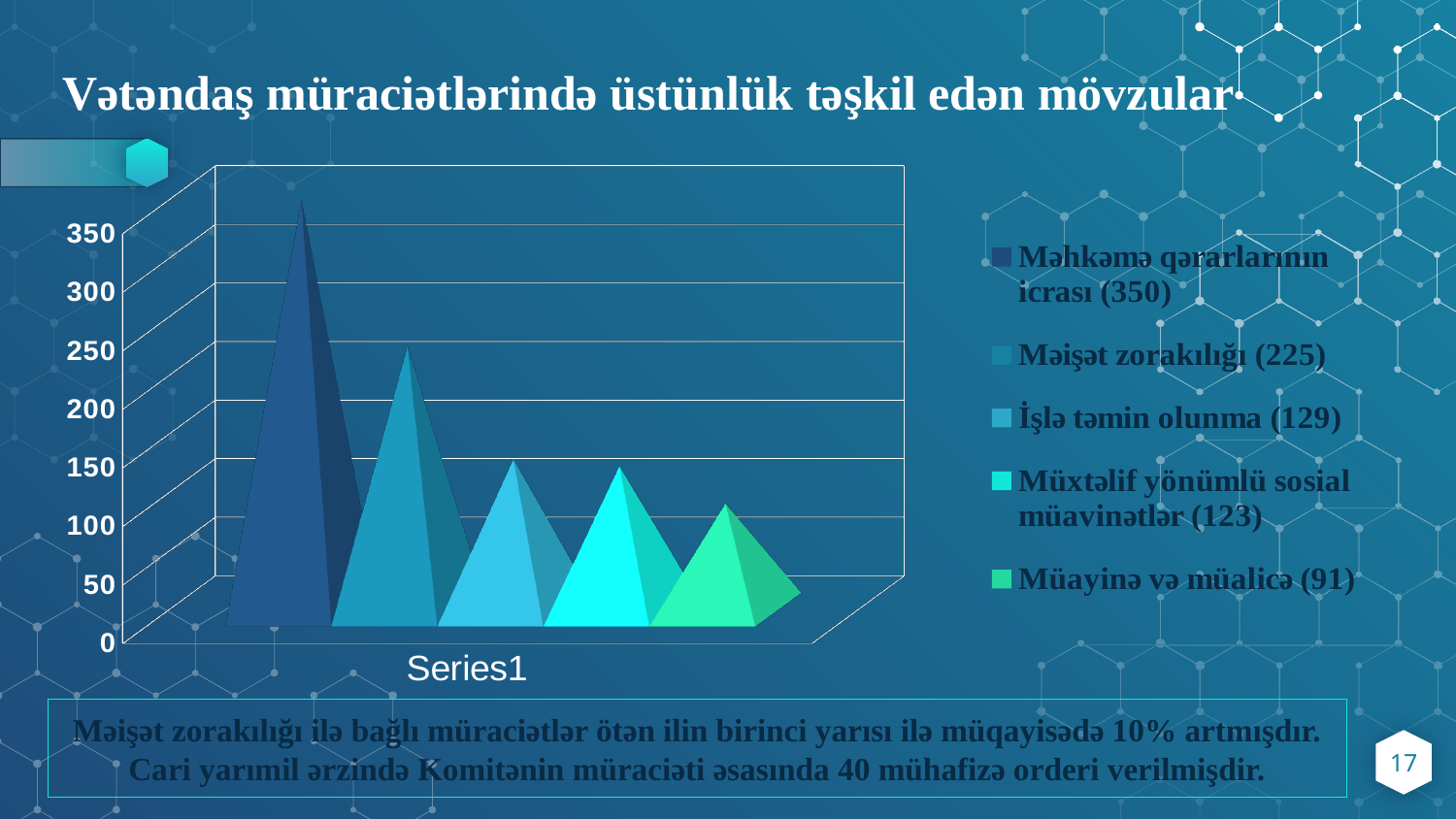
How many categories are plotted in the chart? 5 What value is shown for Müayinə və müalicə? 91 Which category has the lowest value? Müayinə və müalicə Which is larger, the value for Məişət zorakılığı or the value for İşlə təmin olunma? Məişət zorakılığı What is the difference between the values for Məhkəmə qərarlarının icrası and Məişət zorakılığı? 125 Is the value for Müxtəlif yönümlü sosial müavinətlər greater or less than 150? less What value is shown for Məhkəmə qərarlarının icrası? 350 Which category has the highest value? Məhkəmə qərarlarının icrası What value is shown for İşlə təmin olunma? 129 What kind of chart is shown on the slide? bar chart What is the title of the slide above the chart? Vətəndaş müraciətlərində üstünlük təşkil edən mövzular What value is shown for Məişət zorakılığı? 225